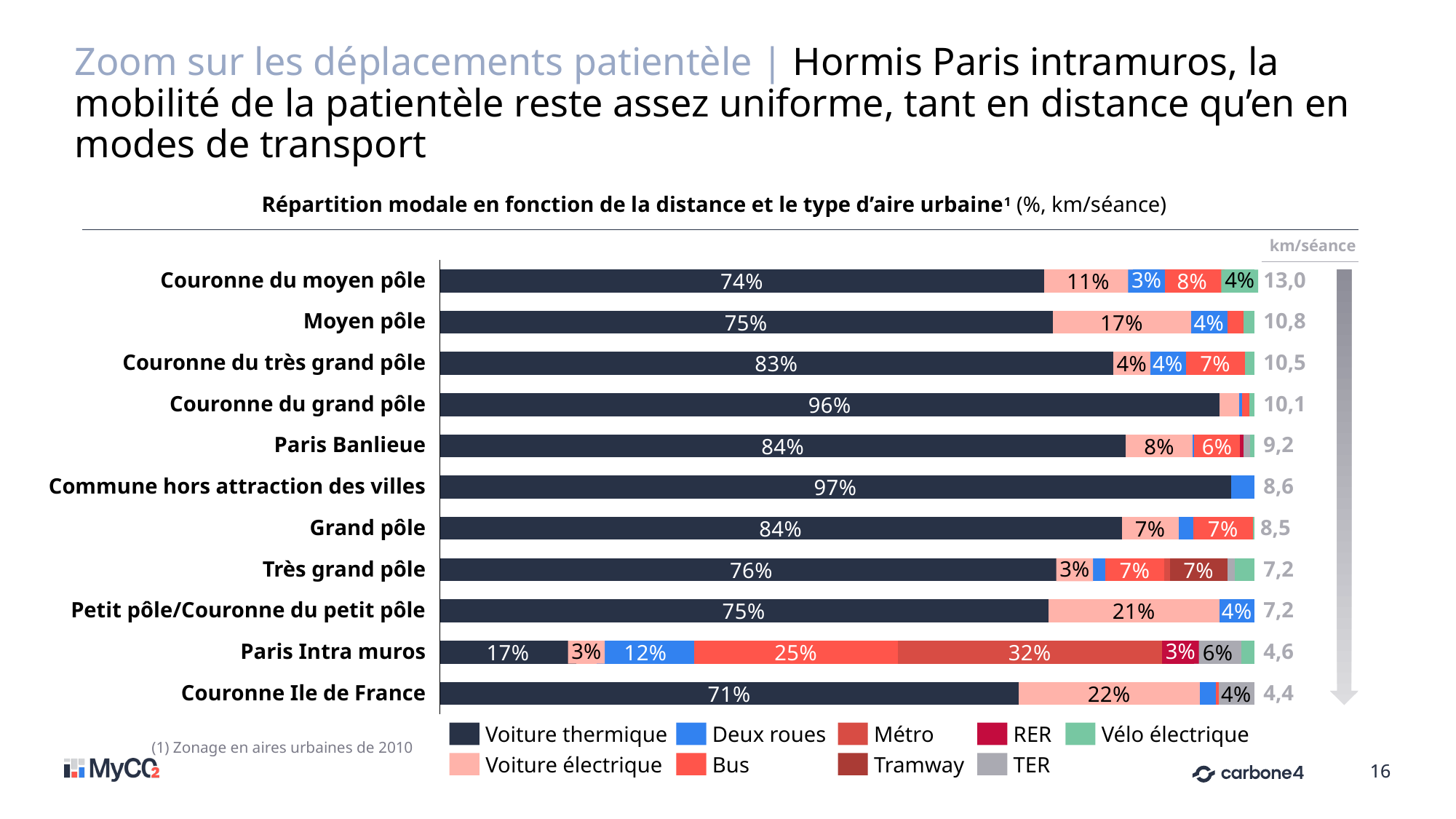
What is the Métro share for Paris Intra muros? 32% Which category has the highest Voiture thermique share? Commune hors attraction des villes Which has the larger Voiture thermique share, Moyen pôle or Couronne du très grand pôle? Couronne du très grand pôle How many urban area categories are plotted in the chart? 11 What is the km/séance value for Couronne du moyen pôle? 13,0 What is the Voiture électrique share for Petit pôle/Couronne du petit pôle? 21% What is the title of the chart? Répartition modale en fonction de la distance et le type d'aire urbaine (%, km/séance) Which category has the lowest Voiture thermique share? Paris Intra muros What is the Voiture thermique share for Paris Intra muros? 17% What kind of chart is shown on the slide? Stacked bar chart What is the difference between the Voiture électrique share for Couronne Ile de France and for Moyen pôle? 5 percentage points How many series does the legend list? 9